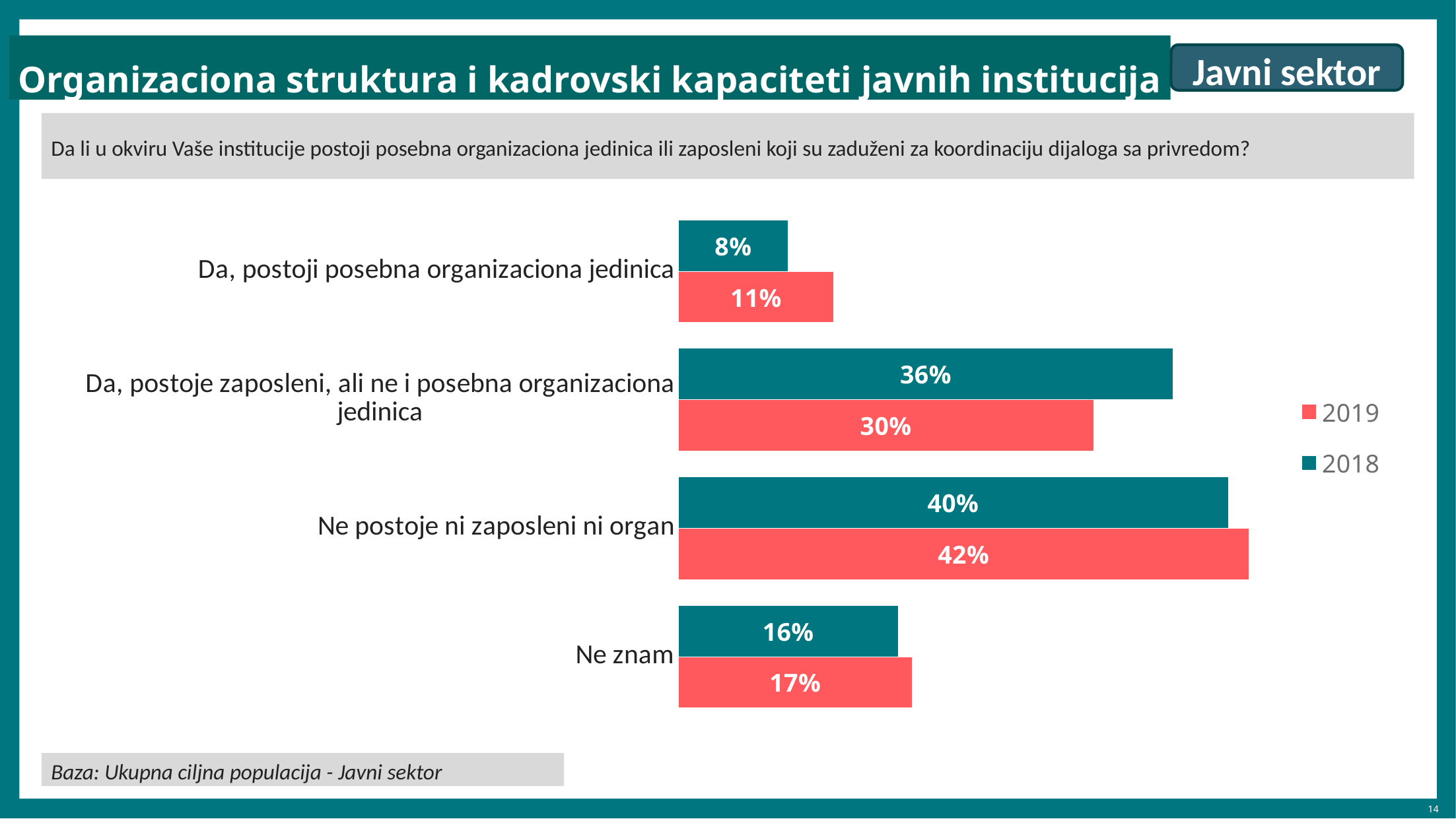
How many categories are shown in the chart? 4 Which category has the highest 2018 value? Ne postoje ni zaposleni ni organ What is the difference between the 2018 and 2019 values for "Da, postoje zaposleni, ali ne i posebna organizaciona jedinica"? 6% What is the 2019 value for "Ne postoje ni zaposleni ni organ"? 42% What is the 2019 value for "Da, postoje zaposleni, ali ne i posebna organizaciona jedinica"? 30% What is the 2018 value for "Da, postoji posebna organizaciona jedinica"? 8% What kind of chart is shown on the slide? Bar chart How many series does the legend list? 2 What is the 2018 value for "Ne znam"? 16% Which colour represents the 2019 series in the chart? Red Which category has the lowest 2019 value? Da, postoji posebna organizaciona jedinica For "Ne znam", which year has the larger value, 2018 or 2019? 2019